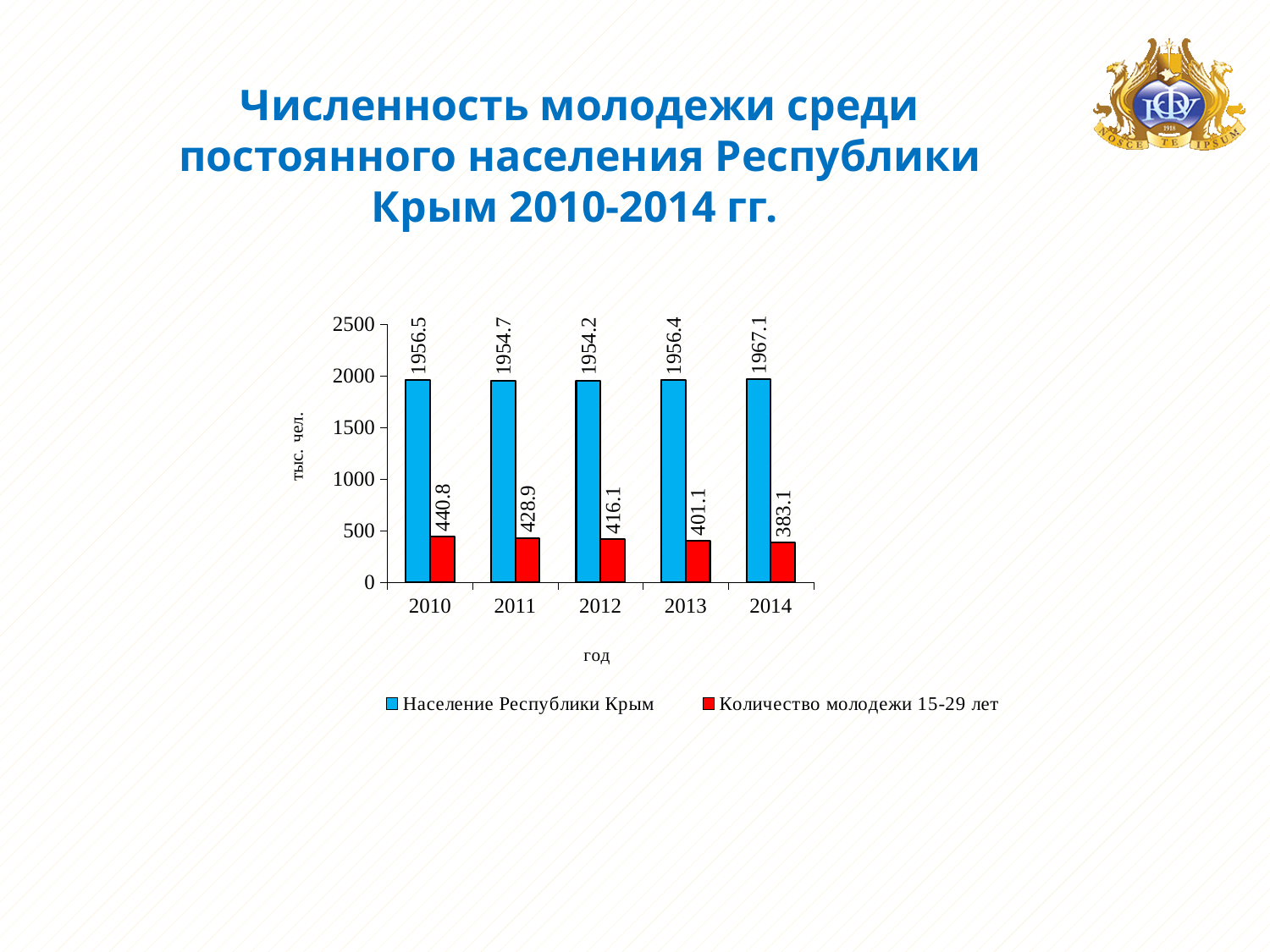
In which year is Количество молодежи 15-29 лет lowest? 2014 Which is larger: Количество молодежи 15-29 лет in 2011 or in 2013? 2011 What is the value for Количество молодежи 15-29 лет in 2010? 440.8 What is the difference between Количество молодежи 15-29 лет in 2010 and in 2014? 57.7 In which year is Количество молодежи 15-29 лет highest? 2010 What is the value for Население Республики Крым in 2014? 1967.1 How many series does the legend list? 2 Is the value for Население Республики Крым in 2012 greater or less than 2000? less Does Количество молодежи 15-29 лет rise or fall from 2010 to 2014? fall What is the value for Количество молодежи 15-29 лет in 2012? 416.1 How many years are shown on the x axis? 5 What kind of chart is shown on the slide? bar chart